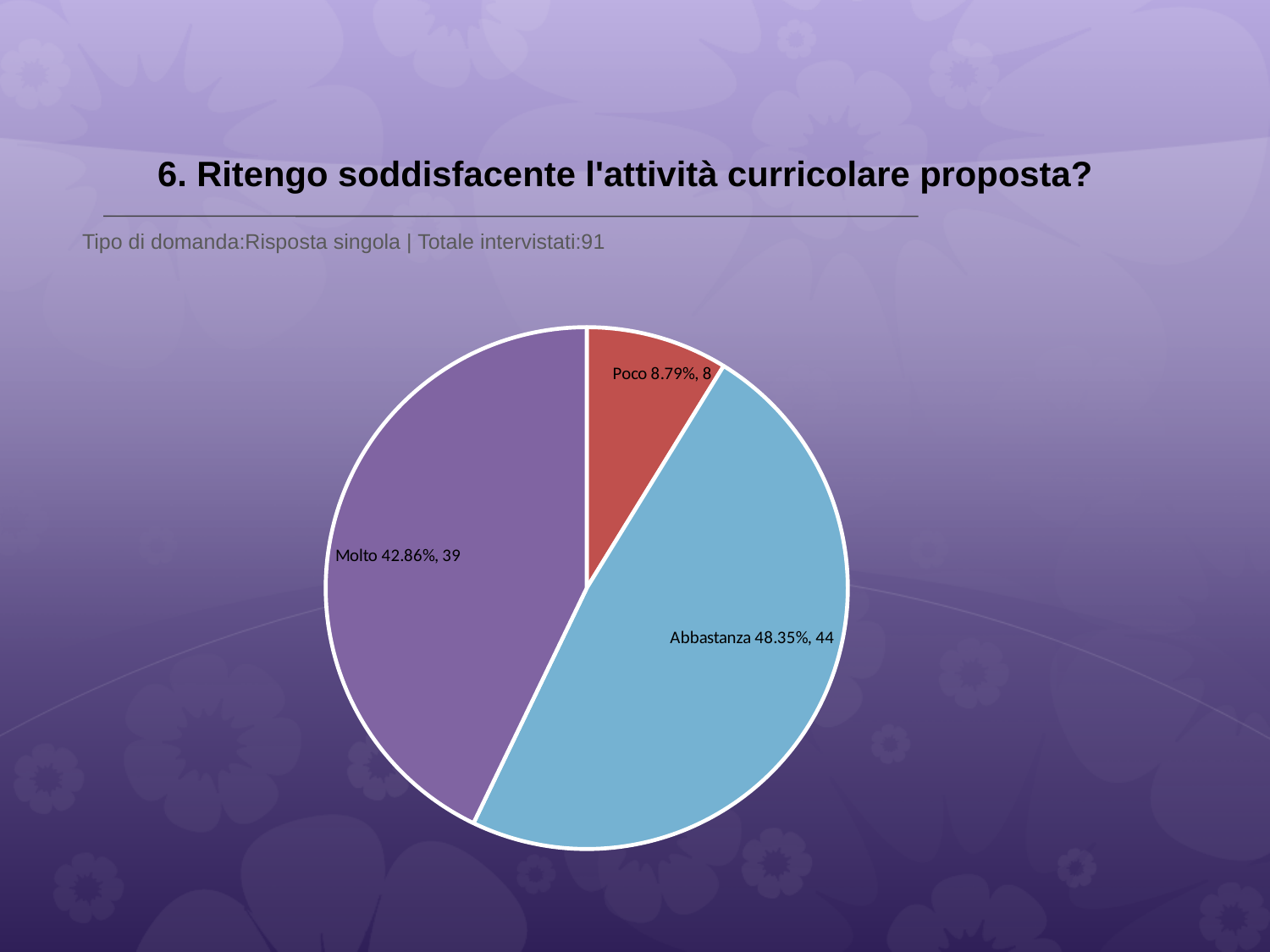
What kind of chart is shown on the slide? pie chart What percentage share does the Poco slice have? 8.79% What percentage share does the Molto slice have? 42.86% Which has more respondents, Molto or Poco? Molto How many respondents answered Molto? 39 Which category has the smallest slice? Poco What is the difference in respondent count between Abbastanza and Molto? 5 What percentage share does the Abbastanza slice have? 48.35% How many respondents answered Poco? 8 Which category has the largest slice? Abbastanza How many slices does the pie chart have? 3 How many respondents answered Abbastanza? 44